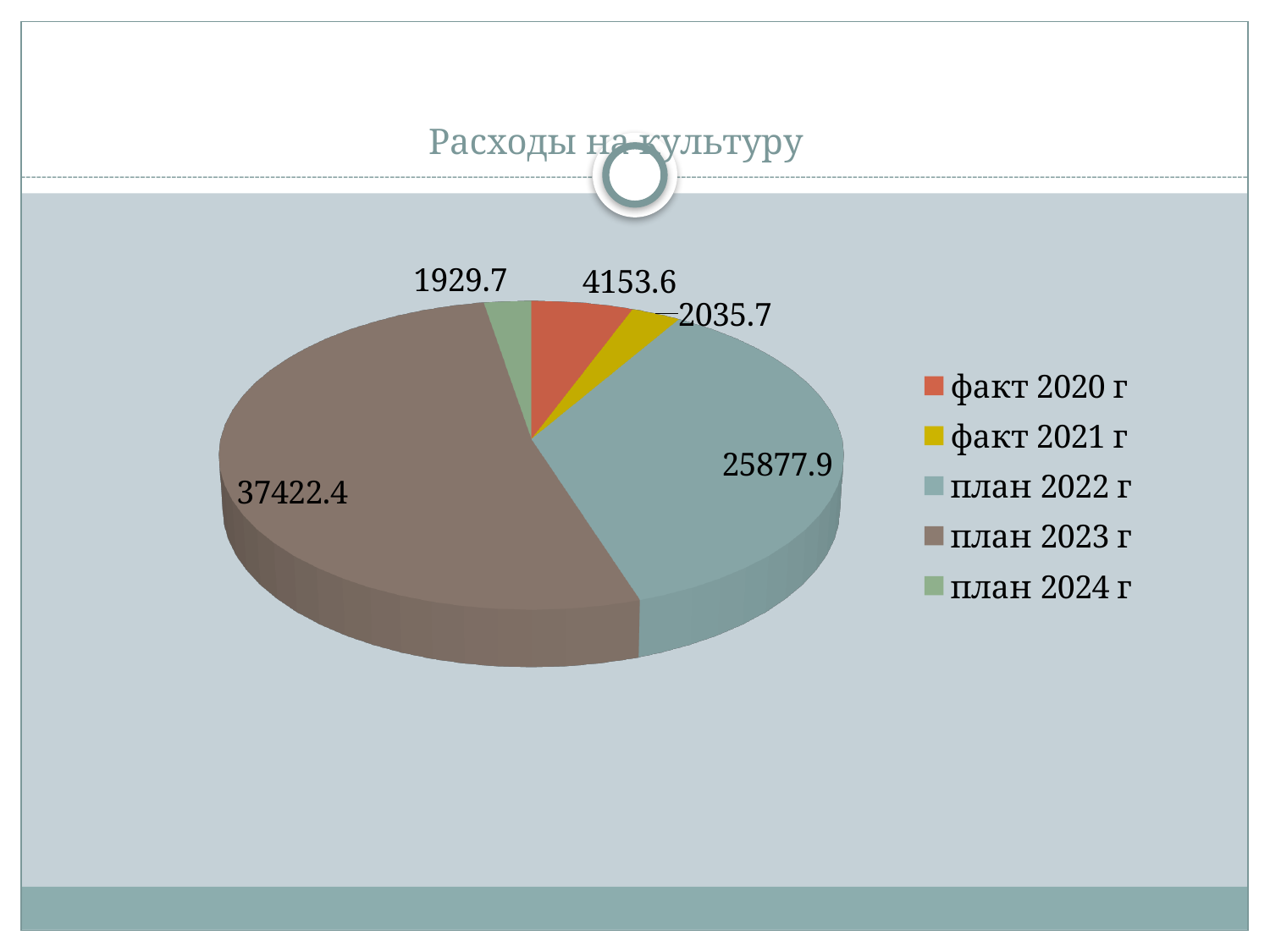
What is the difference between факт 2020 г and факт 2021 г? 2117.9 Which category has the largest value? план 2023 г What is the value for план 2024 г? 1929.7 What is the difference between план 2023 г and план 2022 г? 11544.5 Which category has the smallest value? план 2024 г Which is larger, факт 2020 г or план 2024 г? факт 2020 г How many slices does the pie chart have? 5 What is the value for факт 2021 г? 2035.7 What is the total of all slices in the pie chart? 71419.3 What is the value for план 2023 г? 37422.4 What type of chart is shown on the slide? Pie chart What is the title of the chart? Расходы на культуру